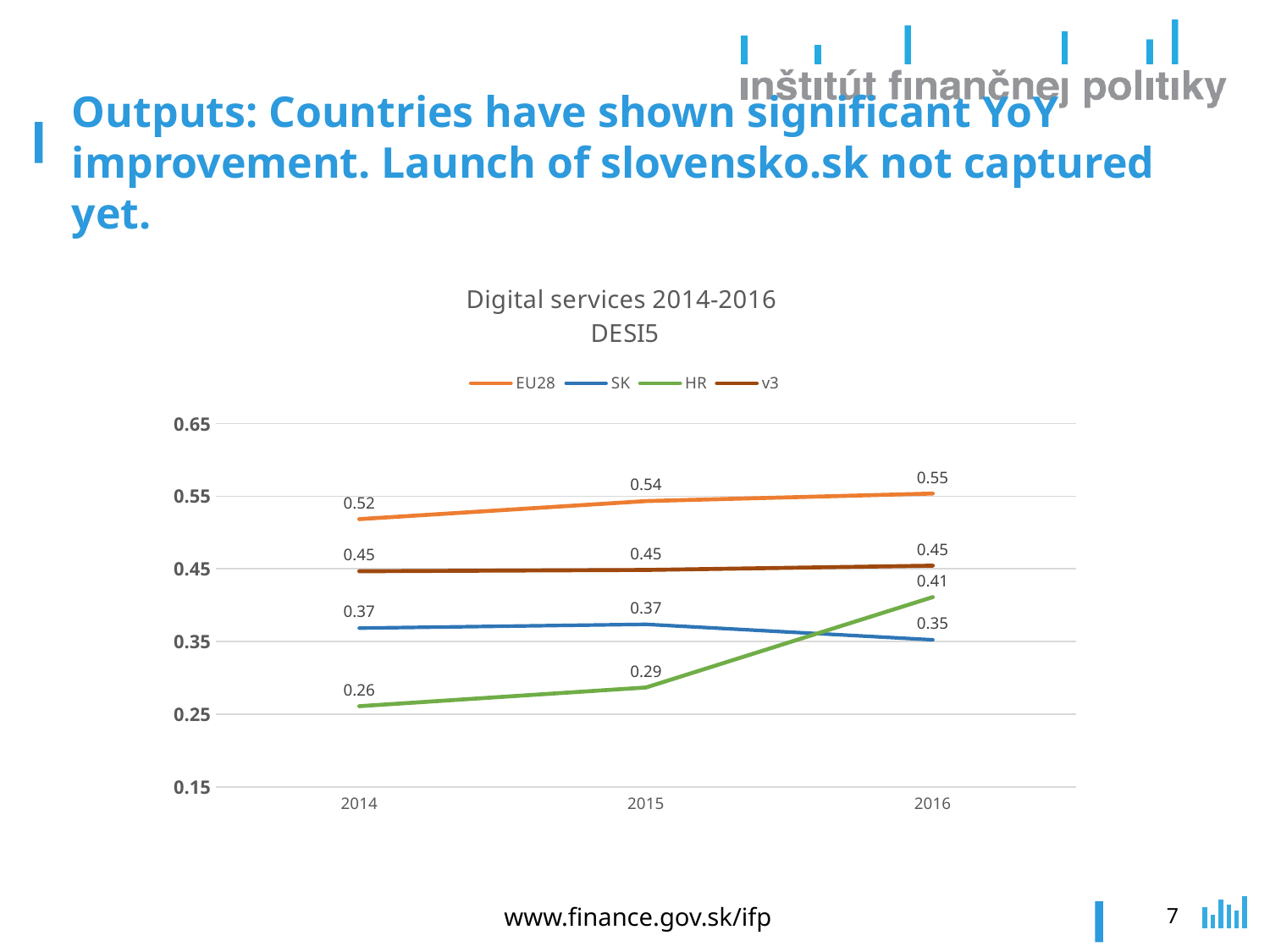
What kind of chart is shown on the slide? line chart Which is larger in 2016, the value for HR or the value for SK? HR What is the value for v3 in 2015? 0.45 Which series has the lowest value in 2014? HR What is the value for EU28 in 2016? 0.55 What is the value for HR in 2014? 0.26 Does the value for HR rise or fall from 2014 to 2016? rise How many series does the legend list? 4 What is the value for SK in 2016? 0.35 What is the difference between the EU28 value in 2016 and the EU28 value in 2014? 0.03 Which series has the highest value in 2016? EU28 How many years are shown on the x axis? 3